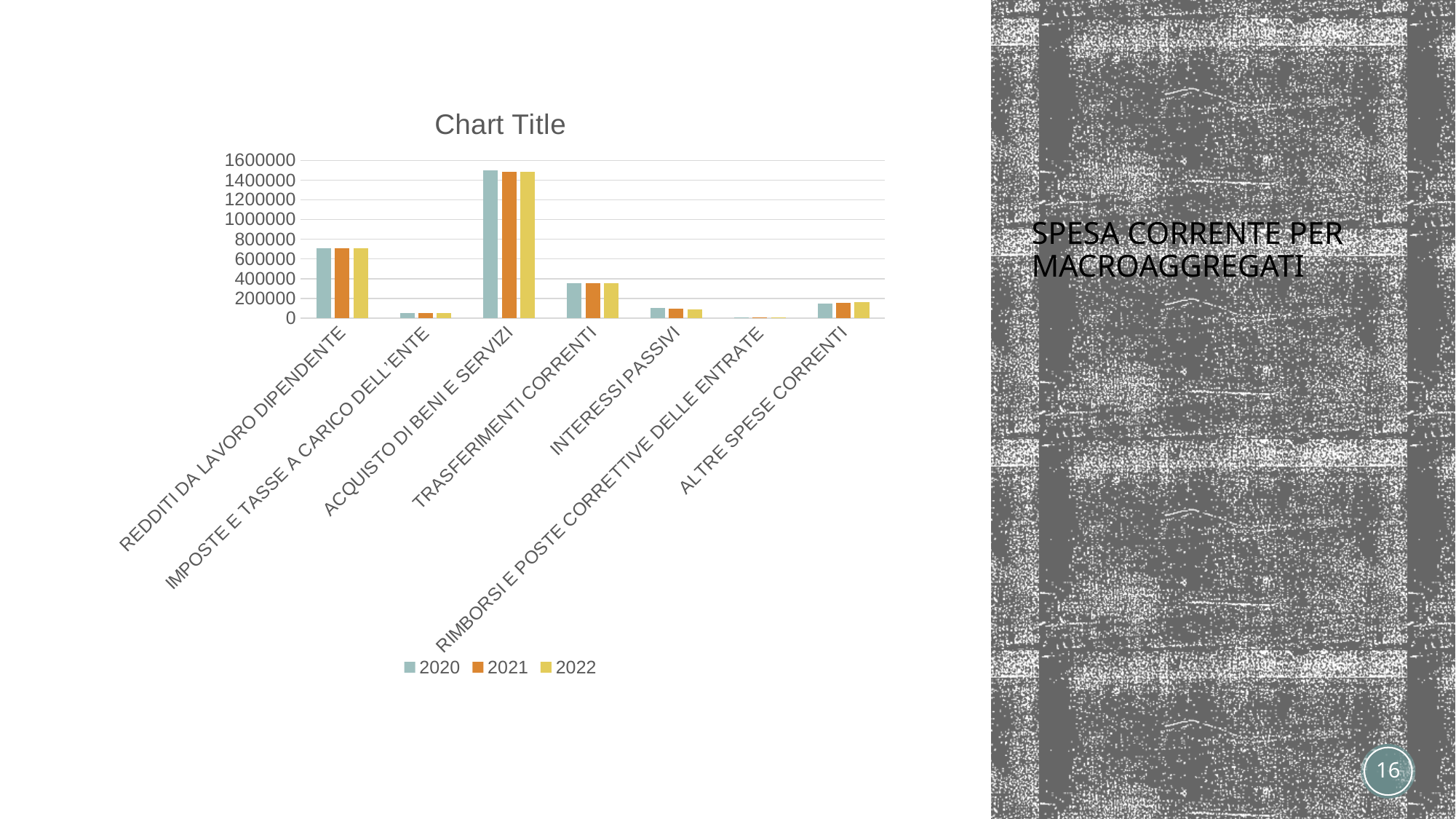
What kind of chart is shown on the slide? bar chart Is the 2020 value for IMPOSTE E TASSE A CARICO DELL'ENTE greater or less than 200000? less Is the 2021 value for ACQUISTO DI BENI E SERVIZI greater or less than 1400000? greater Which is larger in 2022: REDDITI DA LAVORO DIPENDENTE or TRASFERIMENTI CORRENTI? REDDITI DA LAVORO DIPENDENTE How many series does the chart's legend list? 3 What is the title shown above the chart? Chart Title Which is larger in 2021: ALTRE SPESE CORRENTI or INTERESSI PASSIVI? ALTRE SPESE CORRENTI Which category has the highest values in the chart? ACQUISTO DI BENI E SERVIZI How many categories are shown on the x axis of the chart? 7 Is the 2022 value for TRASFERIMENTI CORRENTI greater or less than 400000? less Which category has the lowest values in the chart? RIMBORSI E POSTE CORRETTIVE DELLE ENTRATE